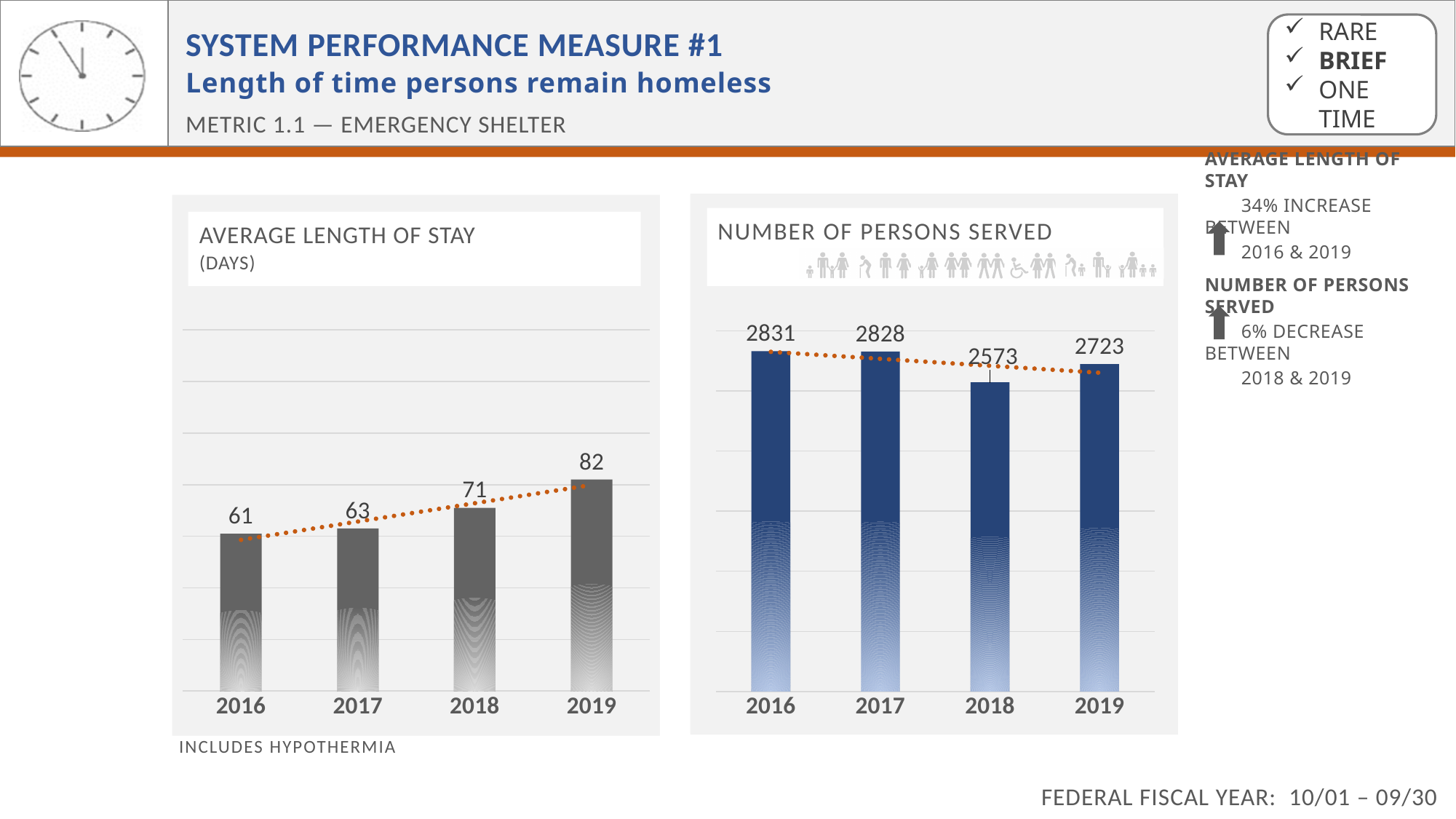
In the Number of Persons Served chart, which year has the lowest value? 2018 In the Average Length of Stay chart, do the values rise or fall from 2016 to 2019? rise What kind of chart is the Average Length of Stay chart? bar chart In the Number of Persons Served chart, what is the difference between the 2019 and 2018 values? 150 In the Average Length of Stay chart, which year has the highest value? 2019 In the Number of Persons Served chart, what is the value for 2018? 2573 In the Number of Persons Served chart, which is larger, the value for 2016 or the value for 2019? 2016 In the Average Length of Stay chart, what is the value for 2019? 82 In the Average Length of Stay chart, what is the difference between the 2019 and 2016 values? 21 In the Average Length of Stay chart, what is the value for 2016? 61 How many years are shown on the x axis of the Number of Persons Served chart? 4 In the Number of Persons Served chart, what is the value for 2017? 2828